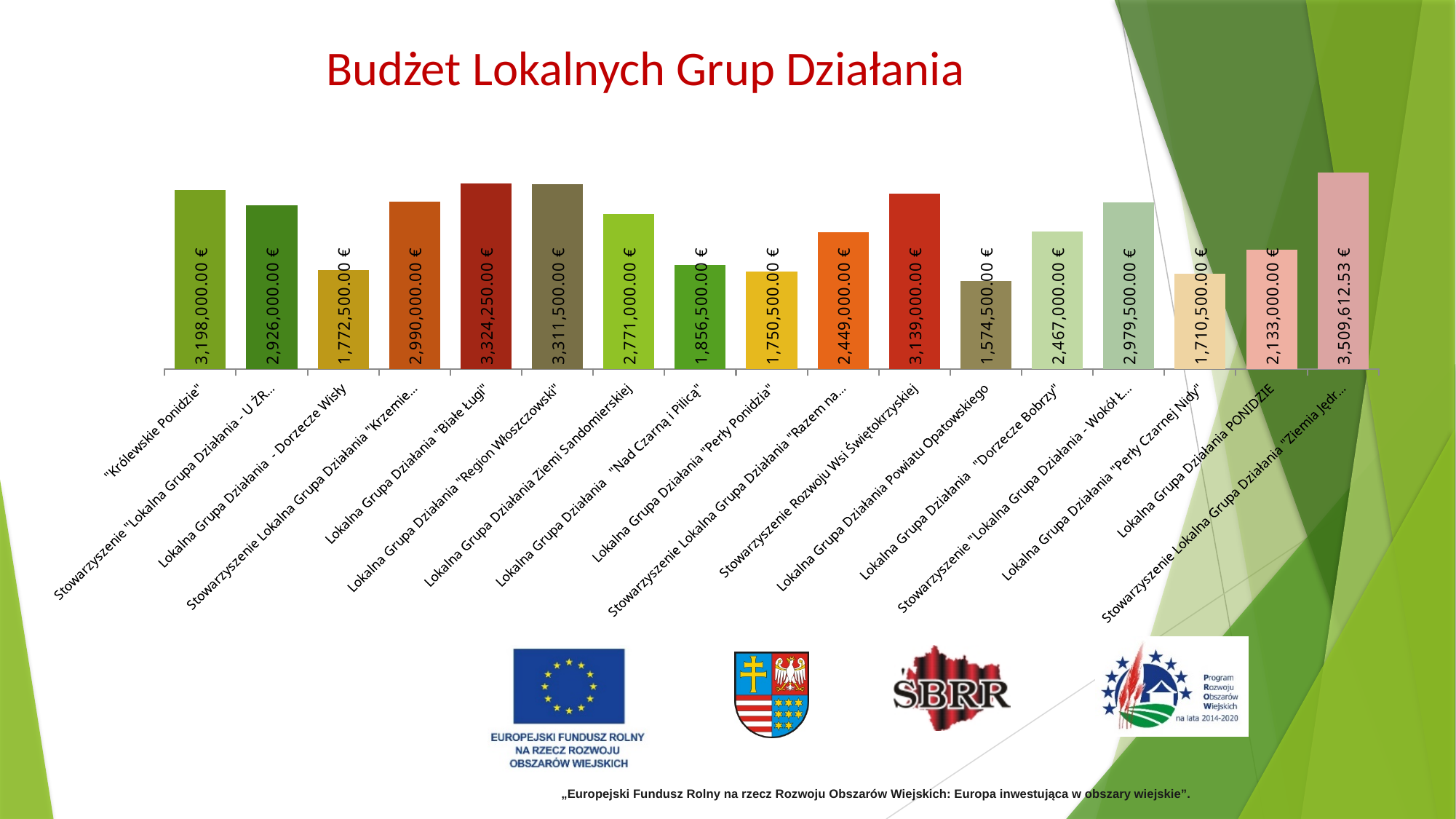
What is the difference between the budget of Lokalna Grupa Działania "Białe Ługi" and Lokalna Grupa Działania "Region Włoszczowski"? 12,750.00 € What is the title of the chart on the slide? Budżet Lokalnych Grup Działania What is the budget value shown for "Królewskie Ponidzie"? 3,198,000.00 € Which has a larger budget: Stowarzyszenie Rozwoju Wsi Świętokrzyskiej or Lokalna Grupa Działania "Dorzecze Bobrzy"? Stowarzyszenie Rozwoju Wsi Świętokrzyskiej What kind of chart is shown on the slide? Bar chart How many categories (bars) are shown in the chart? 17 What is the budget value shown for Lokalna Grupa Działania "Nad Czarną i Pilicą"? 1,856,500.00 € What is the budget value shown for Lokalna Grupa Działania "Białe Ługi"? 3,324,250.00 € Which category has the lowest budget value in the chart? Lokalna Grupa Działania Powiatu Opatowskiego Which category has the highest budget value in the chart? Stowarzyszenie Lokalna Grupa Działania "Ziemia Jędr... What is the difference between the budget of "Królewskie Ponidzie" and Lokalna Grupa Działania - Dorzecze Wisły? 1,425,500.00 € What is the budget value shown for Lokalna Grupa Działania Powiatu Opatowskiego? 1,574,500.00 €